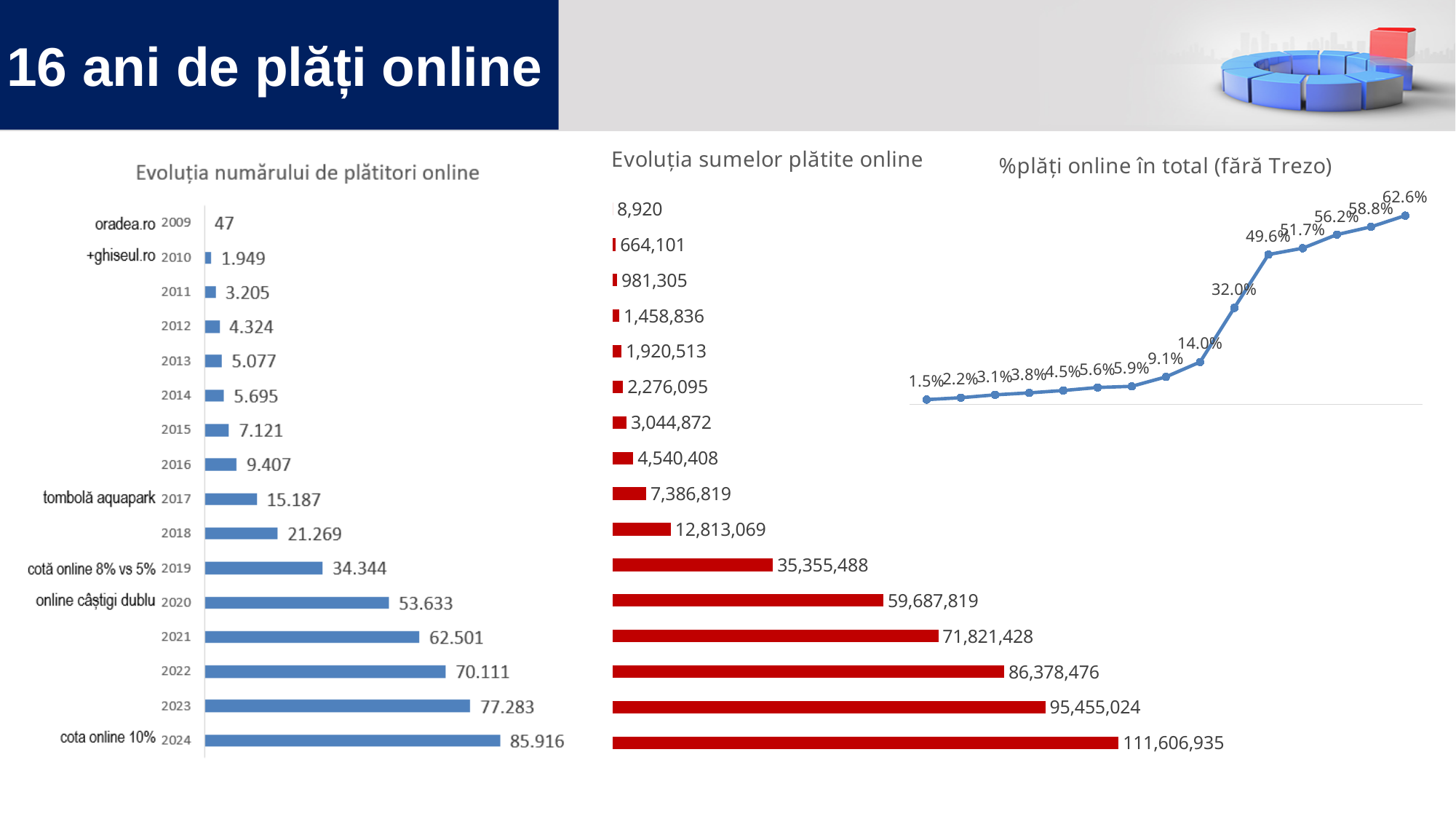
In the chart 'Evoluția sumelor plătite online', what is the difference between the two longest bars (111,606,935 and 95,455,024)? 16,151,911 In the chart '%plăți online în total (fără Trezo)', what is the highest value shown? 62.6% In the chart 'Evoluția numărului de plătitori online', what is the value for 2009? 47 What kind of chart is 'Evoluția numărului de plătitori online'? Bar chart In the chart 'Evoluția numărului de plătitori online', what is the value for 2024? 85.916 In the chart 'Evoluția sumelor plătite online', what is the smallest value shown? 8,920 In the chart 'Evoluția numărului de plătitori online', how many years are shown? 16 In the chart 'Evoluția sumelor plătite online', what is the value of the longest bar? 111,606,935 In the chart 'Evoluția numărului de plătitori online', what is the difference between the values for 2024 and 2023? 8.633 In the chart '%plăți online în total (fără Trezo)', do the values rise or fall from left to right? Rise In the chart 'Evoluția numărului de plătitori online', which year has the highest value? 2024 In the chart 'Evoluția numărului de plătitori online', what is the value for 2019? 34.344